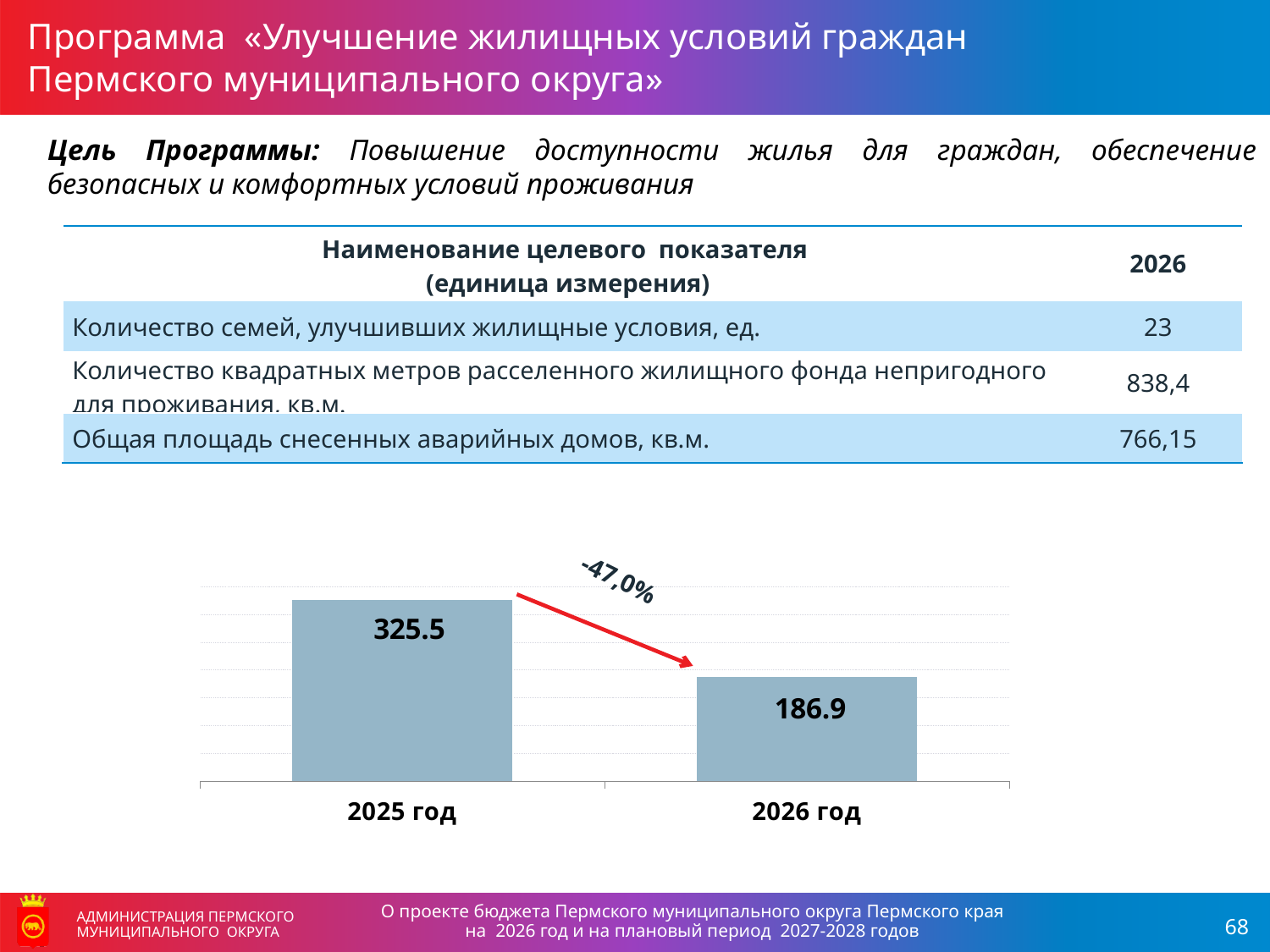
Which year has the lowest value in the bar chart? 2026 год What is the value for 2025 год in the bar chart? 325.5 What percentage change is written next to the arrow in the chart? -47,0% Do the values in the chart rise or fall from 2025 год to 2026 год? fall What kind of chart is shown on the slide? bar chart Which year has the highest value in the bar chart? 2025 год What colour is the arrow drawn between the two bars in the chart? red Which is larger in the bar chart: the value for 2025 год or for 2026 год? 2025 год What is the difference between the values for 2025 год and 2026 год in the bar chart? 138.6 How many bars are shown in the chart? 2 What is the value for 2026 год in the bar chart? 186.9